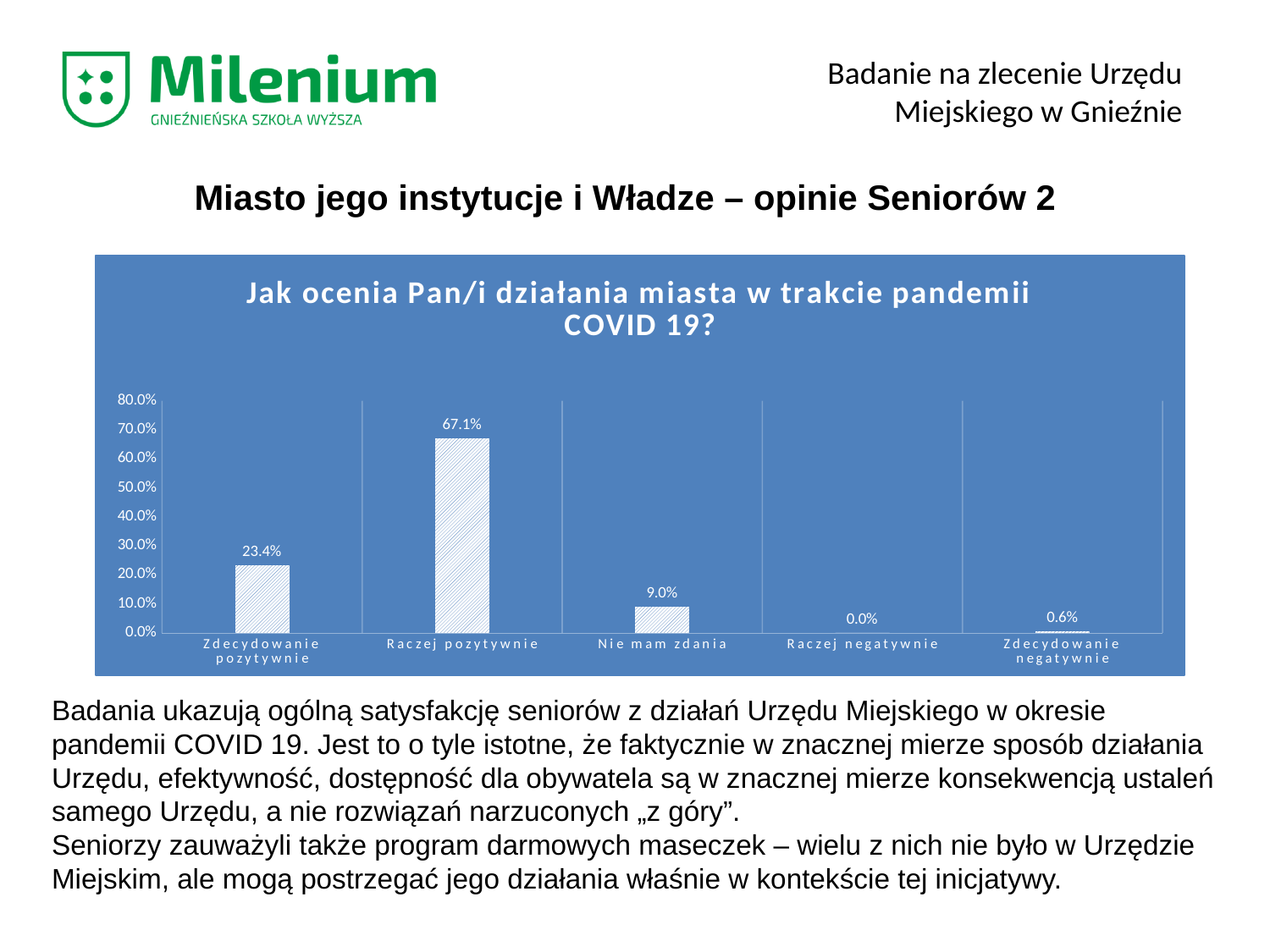
What is the value for "Zdecydowanie negatywnie"? 0.6% Which category has the highest value? Raczej pozytywnie What kind of chart is shown on the slide? bar chart What is the value for "Zdecydowanie pozytywnie"? 23.4% How many categories are shown on the x axis? 5 What is the value for "Raczej pozytywnie"? 67.1% Which is larger, the value for "Nie mam zdania" or the value for "Zdecydowanie pozytywnie"? Zdecydowanie pozytywnie What is the value for "Nie mam zdania"? 9.0% Which category has the lowest value? Raczej negatywnie What is the title of the chart? Jak ocenia Pan/i działania miasta w trakcie pandemii COVID 19? What is the difference between the values for "Raczej pozytywnie" and "Zdecydowanie pozytywnie"? 43.7% Is the value for "Raczej pozytywnie" greater or less than 60.0%? greater